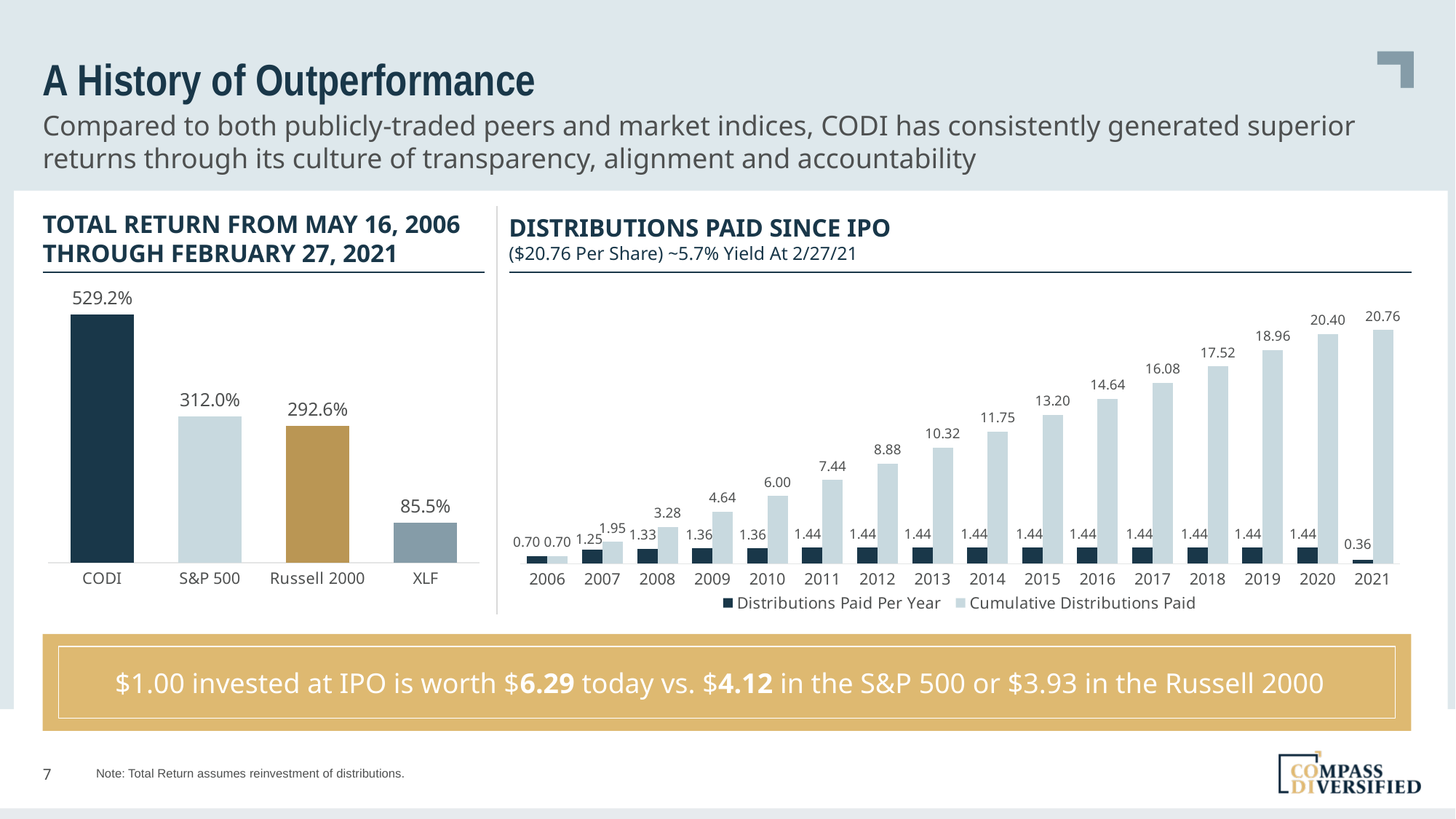
In the 'Distributions Paid Since IPO' chart, what is the difference between the cumulative distributions paid in 2021 and 2020? 0.36 In the 'Total Return from May 16, 2006 through February 27, 2021' chart, which category has the lowest total return? XLF In the 'Distributions Paid Since IPO' chart, how many years are shown on the x axis? 16 In the 'Total Return from May 16, 2006 through February 27, 2021' chart, which is larger, the S&P 500 or the Russell 2000 total return? S&P 500 In the 'Distributions Paid Since IPO' chart, what is the cumulative distributions paid value for 2015? 13.20 In the 'Total Return from May 16, 2006 through February 27, 2021' chart, what is the difference between the CODI and S&P 500 total returns? 217.2% In the 'Distributions Paid Since IPO' chart, what is the distributions paid per year value for 2008? 1.33 In the 'Distributions Paid Since IPO' chart, do the cumulative distributions paid values rise or fall from 2006 to 2021? rise What kind of chart is the 'Distributions Paid Since IPO' chart? bar chart In the 'Total Return from May 16, 2006 through February 27, 2021' chart, what is the total return for CODI? 529.2% In the 'Total Return from May 16, 2006 through February 27, 2021' chart, how many categories are shown? 4 In the 'Distributions Paid Since IPO' chart, how many series does the legend list? 2